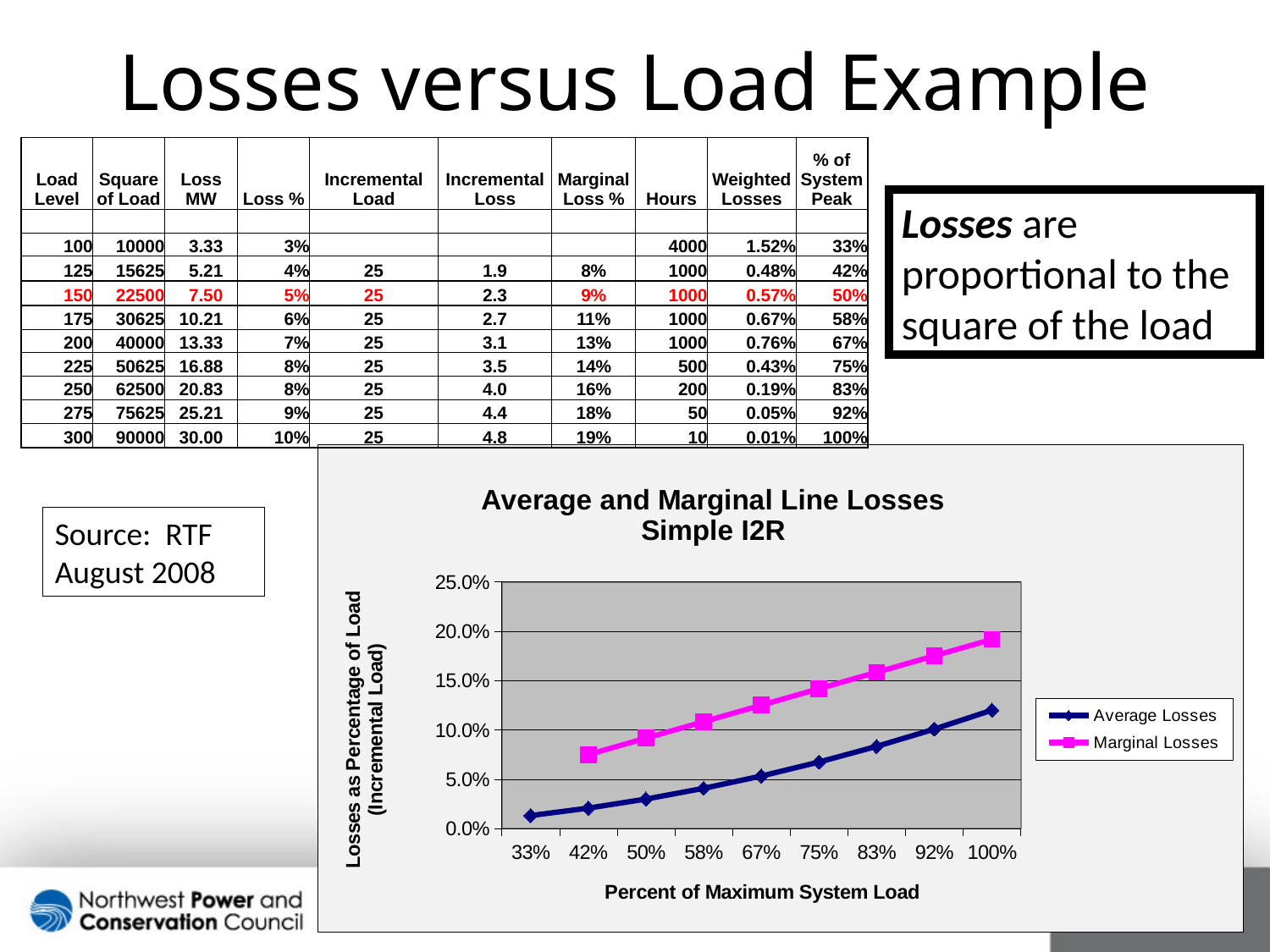
Is the value for Average Losses at 100% greater or less than 10.0%? greater Is the value for Marginal Losses at 100% greater or less than 15.0%? greater What is the label on the x axis of the chart? Percent of Maximum System Load Is the value for Marginal Losses at 42% greater or less than 10.0%? less How many series does the chart legend list? 2 Do the Average Losses values rise or fall as the percent of maximum system load increases? rise What is the title of the chart? Average and Marginal Line Losses Simple I2R What kind of chart is shown on the slide? line chart At 100% of maximum system load, which series has the larger value, Average Losses or Marginal Losses? Marginal Losses How many categories are shown on the x axis of the chart? 9